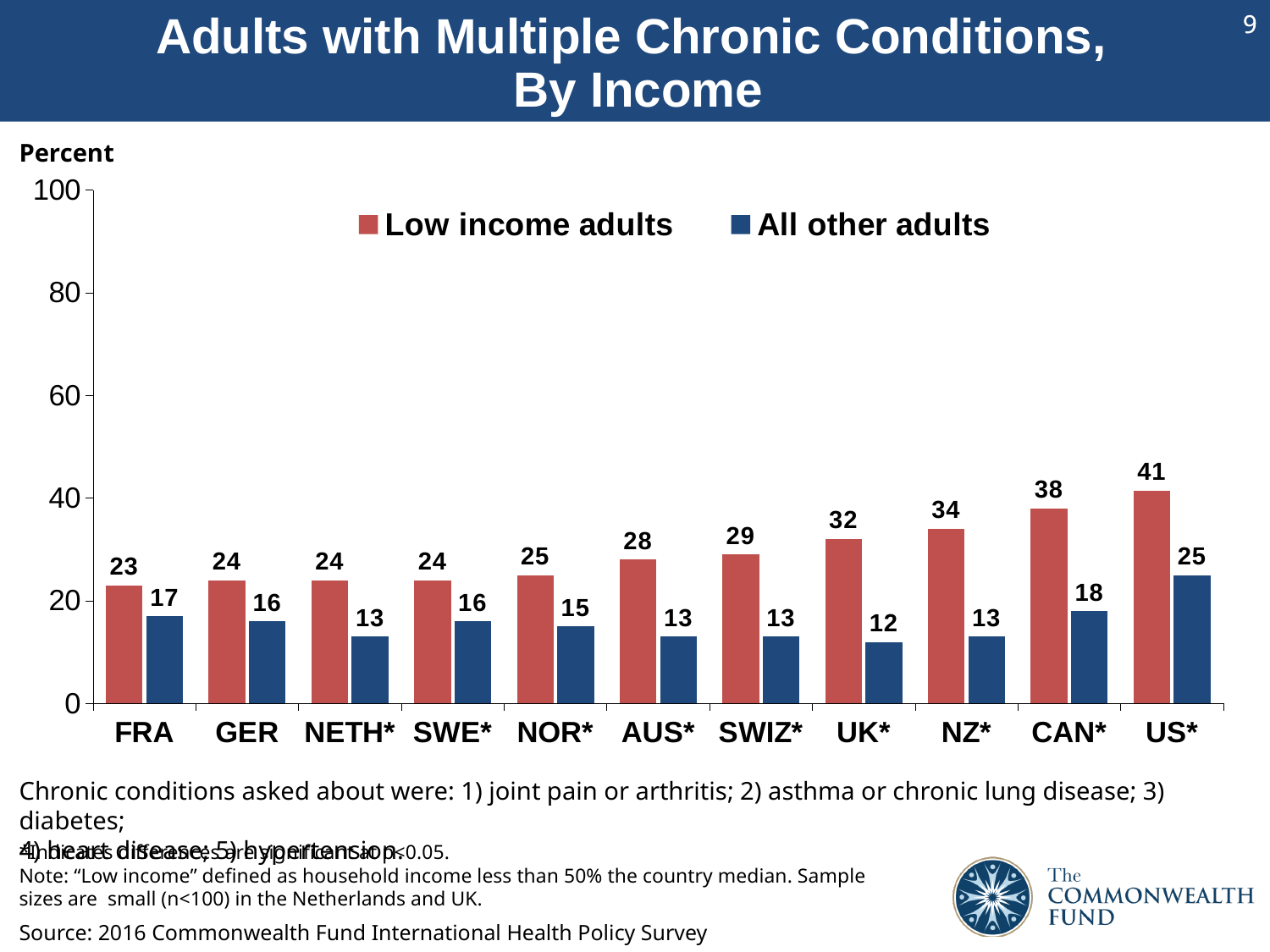
Which is larger: the Low income adults value for NZ* or the Low income adults value for AUS*? NZ* What is the value for Low income adults in US*? 41 What is the difference between Low income adults and All other adults in CAN*? 20 How many countries are shown on the x axis? 11 Is the value for Low income adults in UK* greater or less than 20? greater Which country has the highest value for Low income adults? US* What is the title of the chart? Adults with Multiple Chronic Conditions, By Income What is the value for All other adults in UK*? 12 Which country has the lowest value for All other adults? UK* How many series does the legend list? 2 What is the value for Low income adults in SWIZ*? 29 What kind of chart is shown on the slide? bar chart